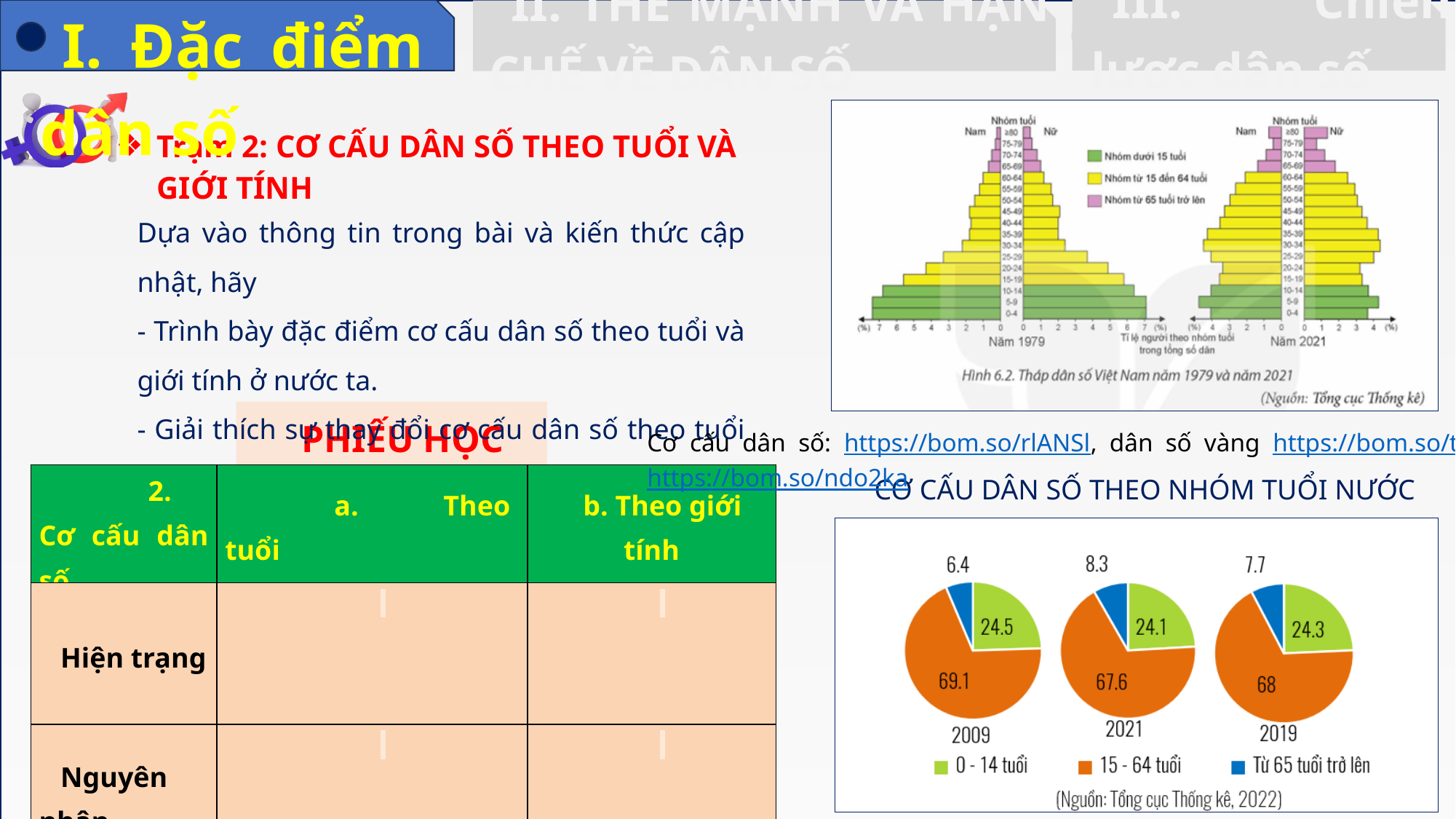
In the pie charts at the bottom right, is the 0 - 14 tuổi share larger in 2009 or in 2019? 2009 How many age groups does the legend of the pie charts at the bottom right list? 3 How many pie charts are shown in the chart titled "CƠ CẤU DÂN SỐ THEO NHÓM TUỔI NƯỚC"? 3 In the pie charts at the bottom right, which year has the lowest share for the 15 - 64 tuổi group? 2021 In the pie charts at the bottom right, what is the share of the Từ 65 tuổi trở lên group in 2019? 7.7 In the pie charts at the bottom right, which year has the highest share for the Từ 65 tuổi trở lên group? 2021 Which two years are compared in the population pyramids of Hình 6.2? 1979 and 2021 In the pie charts at the bottom right, what is the share of the 15 - 64 tuổi group in 2019? 68 In the pie charts at the bottom right, what is the share of the 0 - 14 tuổi group in 2021? 24.1 In the pie charts at the bottom right, what is the difference between the Từ 65 tuổi trở lên share in 2021 and in 2009? 1.9 What kind of chart is Hình 6.2 (Tháp dân số Việt Nam năm 1979 và năm 2021) at the top right? Bar chart (population pyramid) In the pie charts titled "CƠ CẤU DÂN SỐ THEO NHÓM TUỔI NƯỚC", what is the share of the 15 - 64 tuổi group in 2009? 69.1